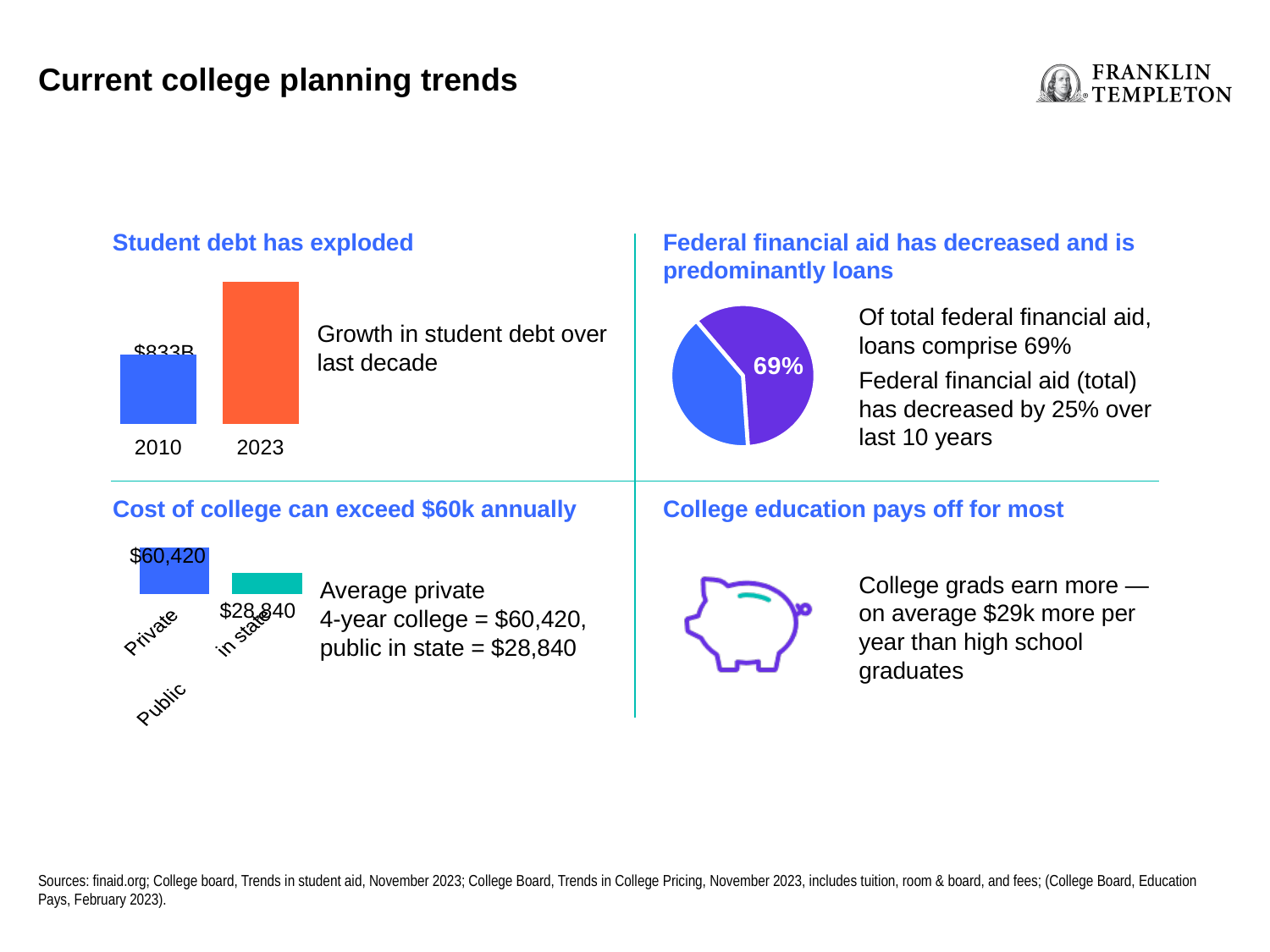
What kind of chart is shown under "Federal financial aid has decreased and is predominantly loans"? pie chart In the "Student debt has exploded" chart, does student debt rise or fall from 2010 to 2023? rise In the "Student debt has exploded" chart, how many years are plotted? 2 In the "Cost of college can exceed $60k annually" chart, what is the difference between the Private and Public in state values? $31,580 In the "Student debt has exploded" chart, what value is labelled on the 2010 bar? $833B How many slices does the pie chart under "Federal financial aid has decreased and is predominantly loans" have? 2 In the pie chart under "Federal financial aid has decreased and is predominantly loans", what share is labelled on the purple slice? 69% In the "Cost of college can exceed $60k annually" chart, what is the value for Private? $60,420 What kind of chart is shown under "Cost of college can exceed $60k annually"? bar chart In the "Cost of college can exceed $60k annually" chart, what is the value for Public in state? $28,840 What kind of chart is shown under "Student debt has exploded"? bar chart In the "Student debt has exploded" chart, which year has the taller bar, 2010 or 2023? 2023